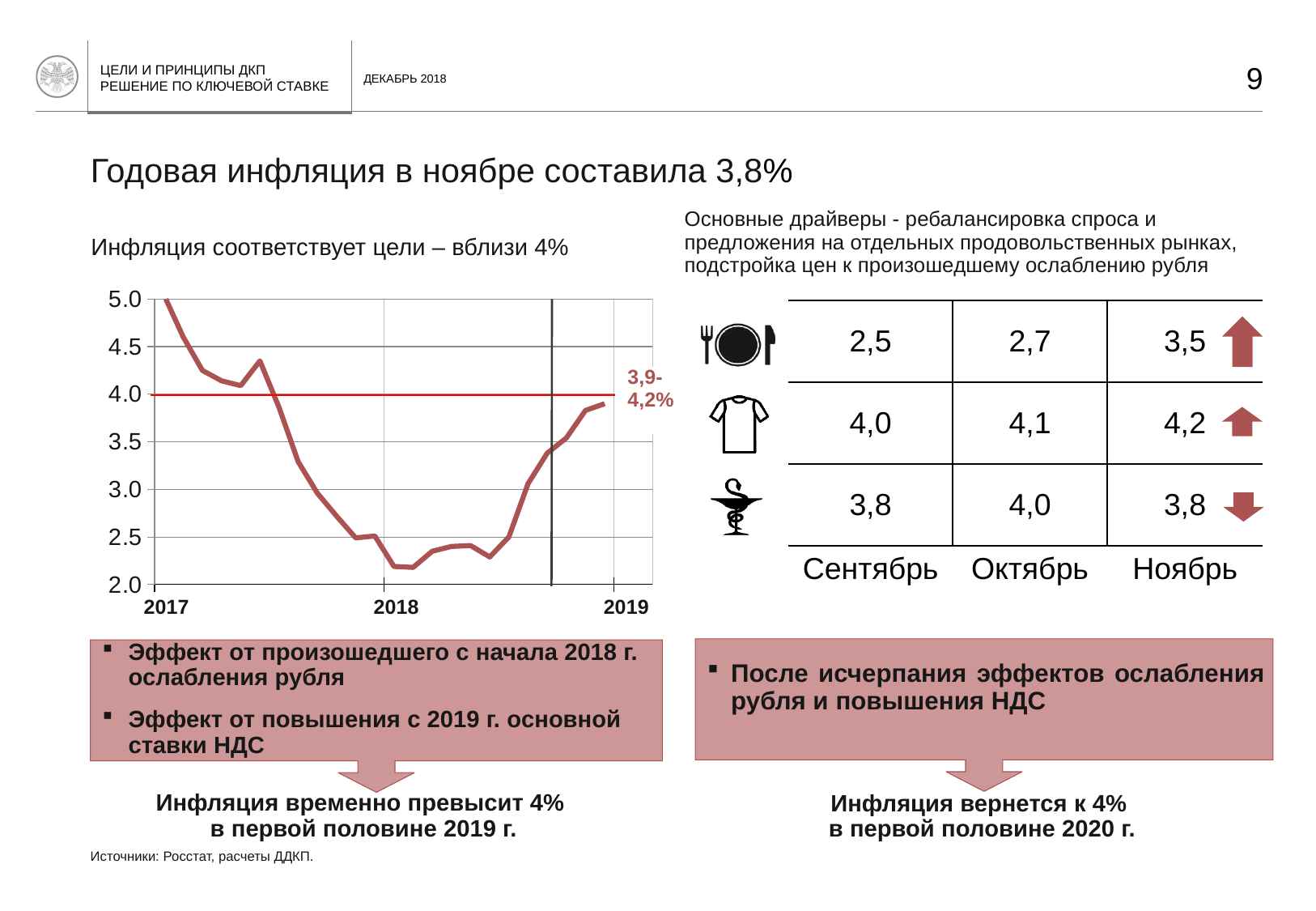
Is the value of the line at the start of 2018 greater or less than 2.0? greater In which year does the line reach its highest point? 2017 Is the value at the right end of the line (late 2018) greater or less than 4.0? less Does the line rise or fall from mid-2018 to the end of 2018? rise What range is written in the annotation next to the right end of the line? 3,9-4,2% What value does the horizontal red line on the chart mark? 4.0 What kind of chart is shown on the slide? line chart What is the value of the line at the start of 2017? 5.0 Is the value at the right end of the line (late 2018) greater or less than 3.5? greater Does the line rise or fall from the start of 2017 to the start of 2018? fall In which year does the line reach its lowest point? 2018